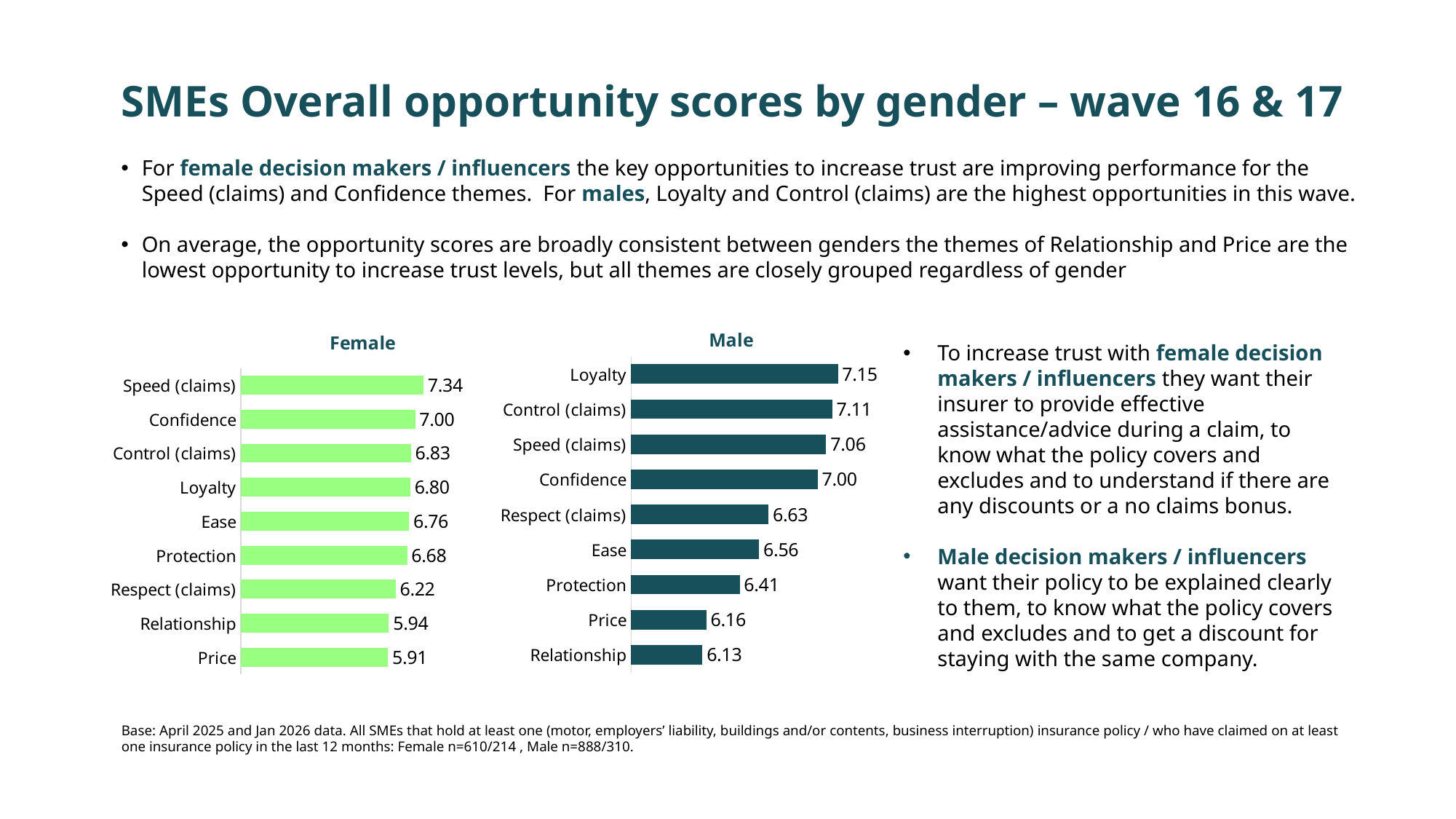
In the Male chart, which category has the highest value? Loyalty In the Female chart, which category has the lowest value? Price In the Male chart, which category has the lowest value? Relationship In the Female chart, what is the difference between Speed (claims) and Price? 1.43 What is the value for Confidence in the Male chart? 7.00 In the Male chart, what is the difference between Loyalty and Relationship? 1.02 How many categories are shown in the Male chart? 9 In the Female chart, what is the value for Speed (claims)? 7.34 Which is larger: Loyalty in the Female chart or Loyalty in the Male chart? Male In the Female chart, which is larger: Confidence or Respect (claims)? Confidence In the Male chart, what is the value for Control (claims)? 7.11 What kind of chart is the Female chart? Bar chart